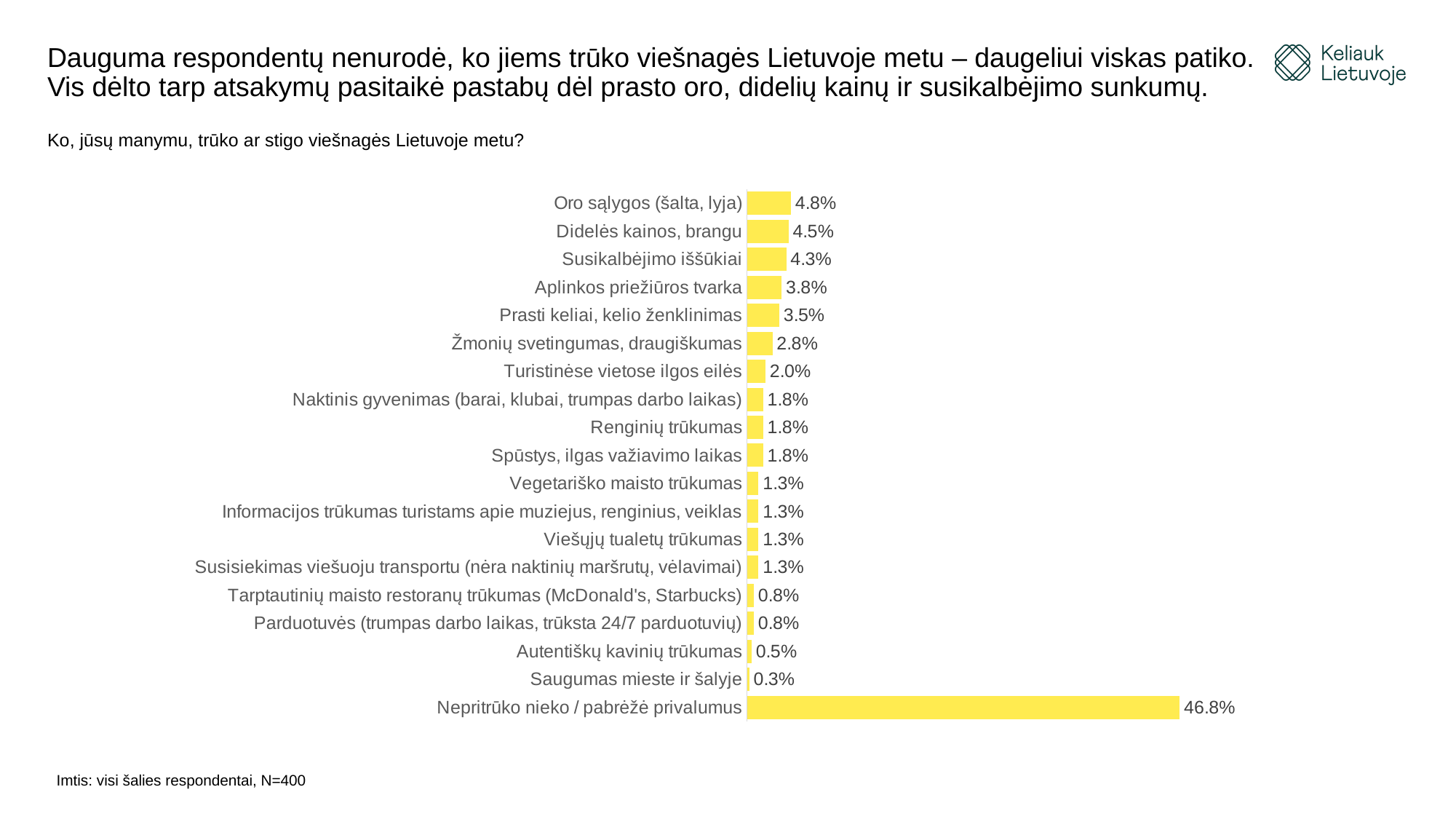
What is the difference between the values for "Oro sąlygos (šalta, lyja)" and "Didelės kainos, brangu"? 0.3% What is the value for "Susikalbėjimo iššūkiai"? 4.3% What colour are the bars in the chart? Yellow Which category has the highest value? Nepritrūko nieko / pabrėžė privalumus What kind of chart is shown on the slide? Bar chart How many categories are shown in the chart? 19 What is the value for "Nepritrūko nieko / pabrėžė privalumus"? 46.8% What is the difference between the values for "Nepritrūko nieko / pabrėžė privalumus" and "Oro sąlygos (šalta, lyja)"? 42.0% Which category has the lowest value? Saugumas mieste ir šalyje What is the value for "Saugumas mieste ir šalyje"? 0.3% Which is larger: the value for "Prasti keliai, kelio ženklinimas" or "Žmonių svetingumas, draugiškumas"? Prasti keliai, kelio ženklinimas What is the value for "Oro sąlygos (šalta, lyja)"? 4.8%